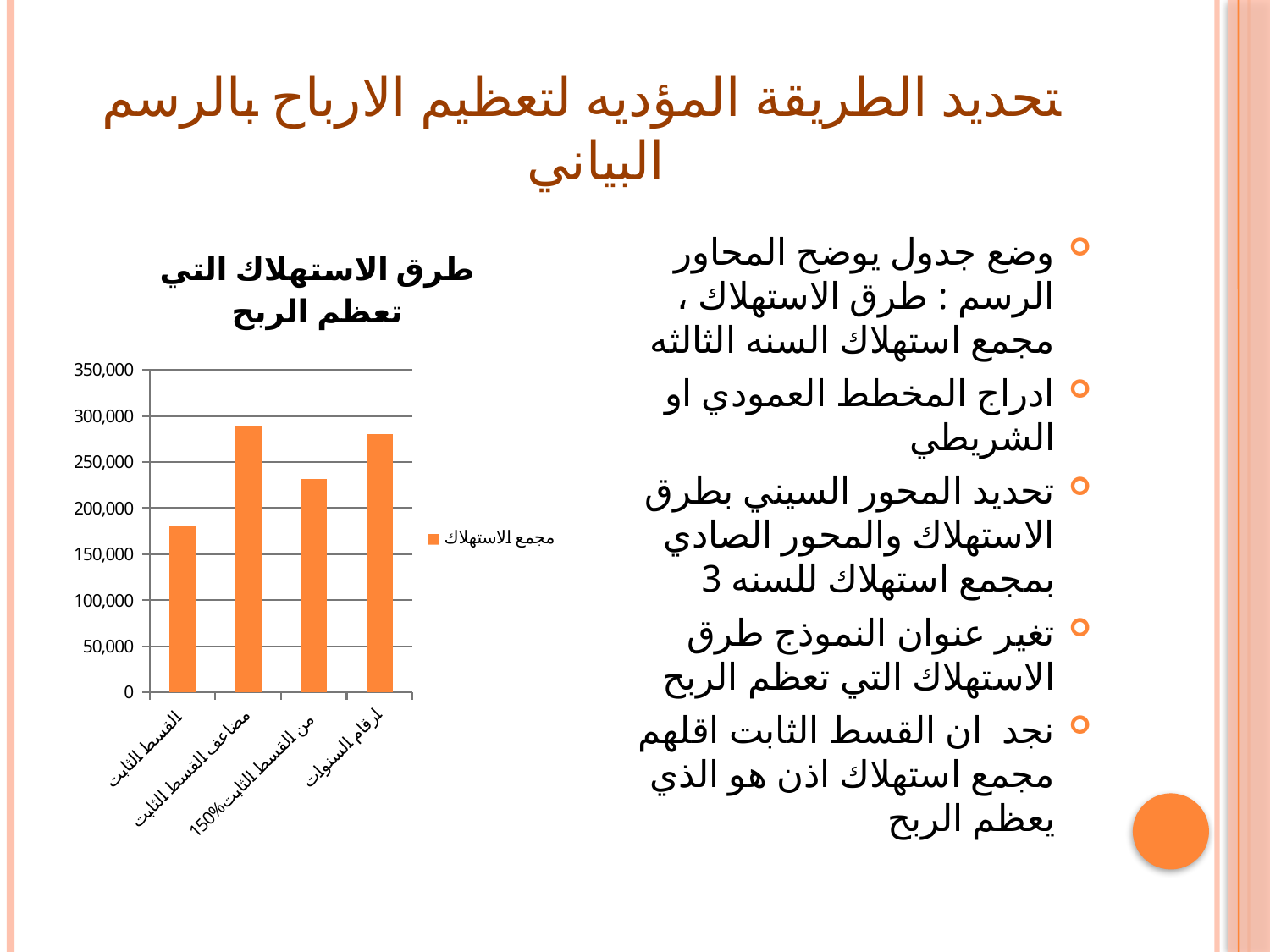
Which is larger, the value for مضاعف القسط الثابت or the value for 150% من القسط الثابت? مضاعف القسط الثابت Is the value for القسط الثابت greater or less than 200,000? less What kind of chart is shown on the slide? Bar chart Which is larger, the value for القسط الثابت or the value for 150% من القسط الثابت? 150% من القسط الثابت What is the title of the chart? طرق الاستهلاك التي تعظم الربح How many categories are shown on the x axis of the chart? 4 How many series does the chart's legend list? 1 Is the value for 150% من القسط الثابت greater or less than 200,000? greater Which category has the lowest value in the chart? القسط الثابت Is the value for ارقام السنوات greater or less than 250,000? greater What is the legend entry of the chart? مجمع الاستهلاك